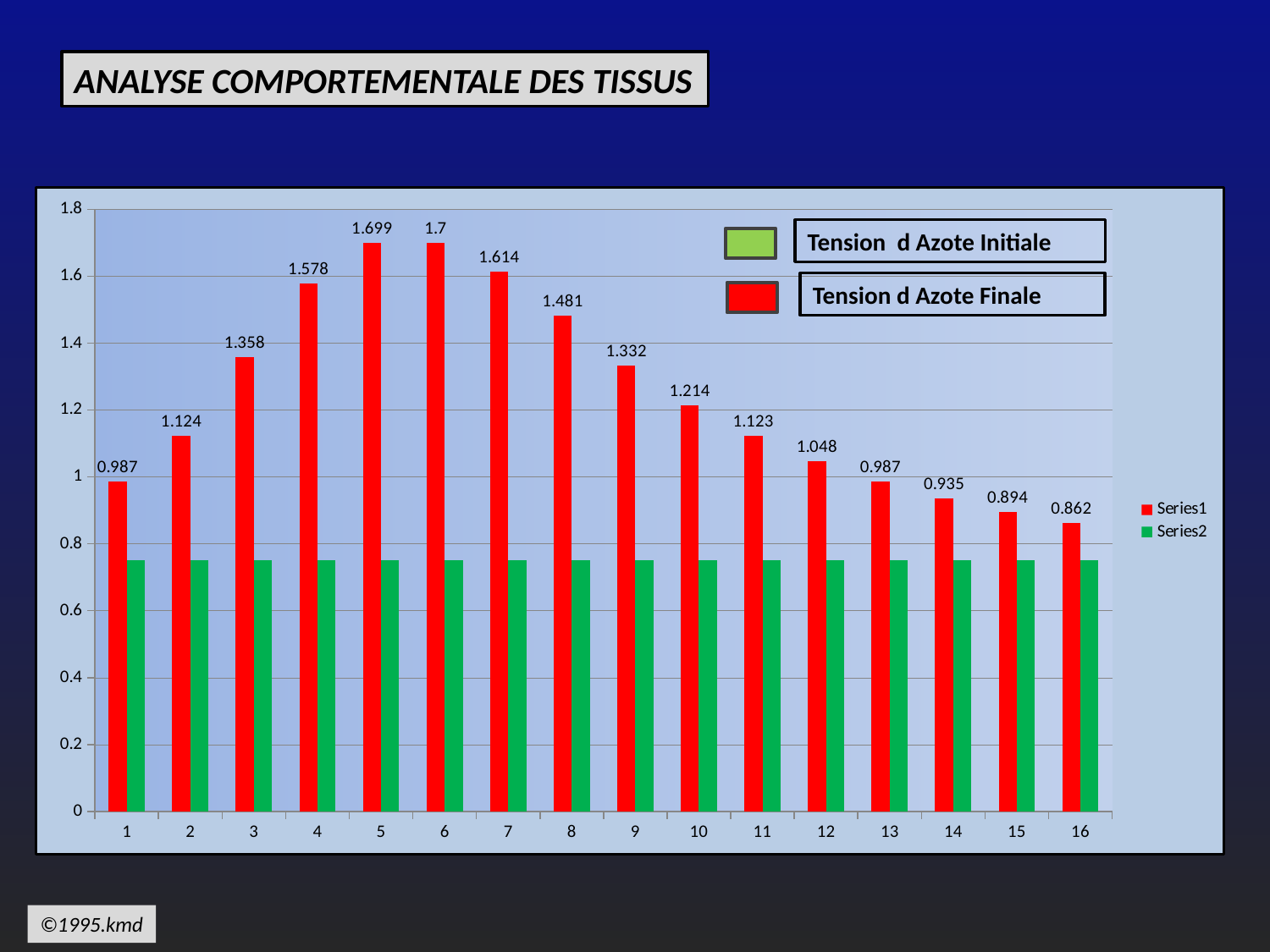
What is the difference between the Series1 values for category 8 and category 9? 0.149 What is the Series1 value for category 5? 1.699 Which category has the lowest Series1 value? 16 What is the Series1 value for category 12? 1.048 How many categories are shown on the x axis? 16 Which is larger, the Series1 value for category 4 or for category 9? category 4 Do the Series1 values rise or fall from category 6 to category 16? fall What is the Series1 value for category 16? 0.862 How many series does the legend list? 2 What is the difference between the Series1 values for category 5 and category 1? 0.712 What kind of chart is shown on the slide? bar chart Is the Series2 value for category 1 greater or less than 0.8? less